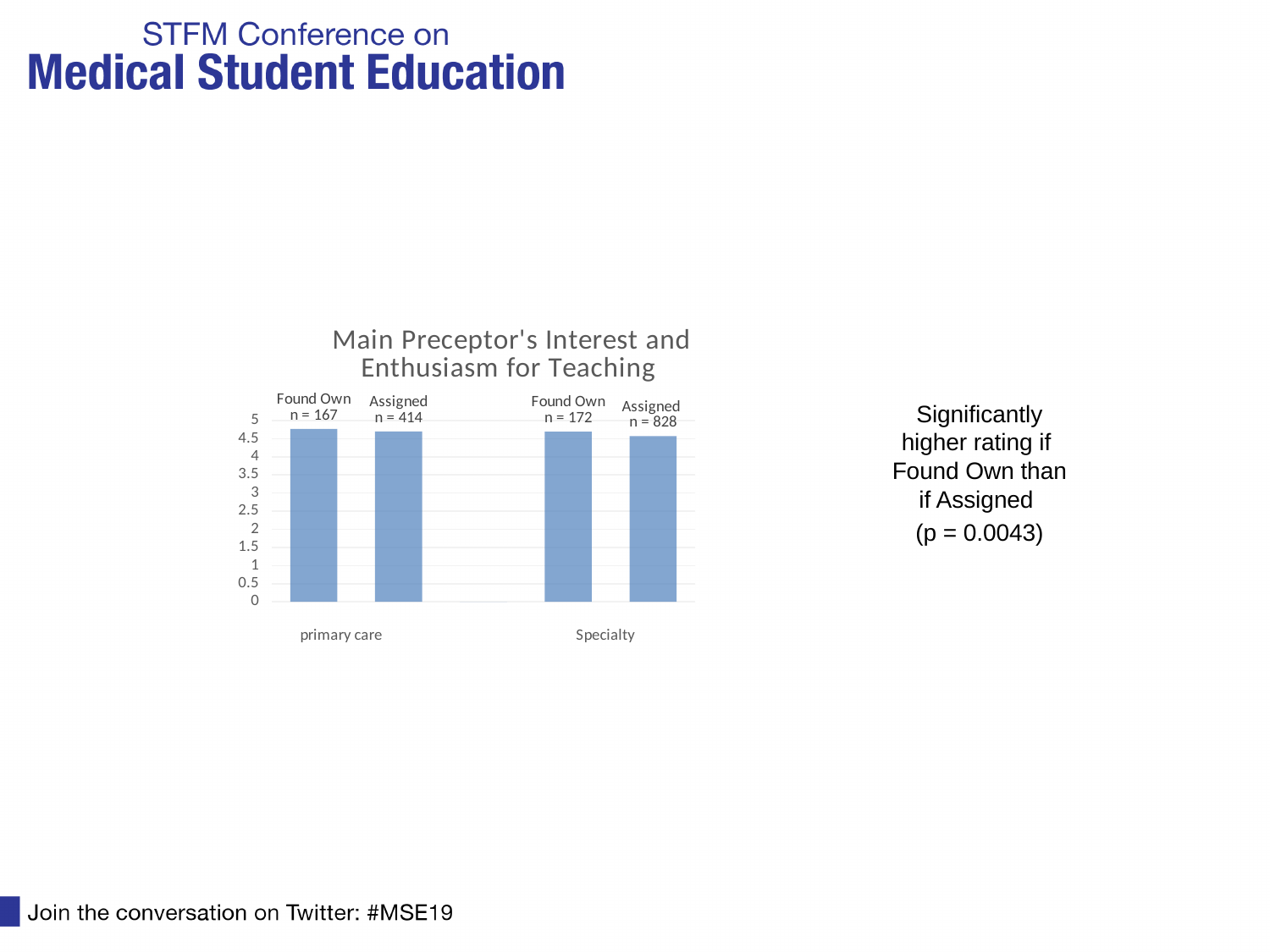
What is the title of the chart? Main Preceptor's Interest and Enthusiasm for Teaching What is the maximum value shown on the y axis of the chart? 5 What kind of chart is shown on the slide? bar chart What is the sample size (n) for the Found Own bar in the primary care group? n = 167 What are the two group labels shown along the x axis of the chart? primary care and Specialty What is the sample size (n) for the Assigned bar in the primary care group? n = 414 Is the value for Found Own in the primary care group greater or less than 4? greater Which is larger: the Found Own bar in the primary care group or the Assigned bar in the Specialty group? Found Own in primary care What is the sample size (n) for the Assigned bar in the Specialty group? n = 828 What is the sample size (n) for the Found Own bar in the Specialty group? n = 172 Is the value for Assigned in the Specialty group greater or less than 5? less How many bars are plotted in the chart? 4